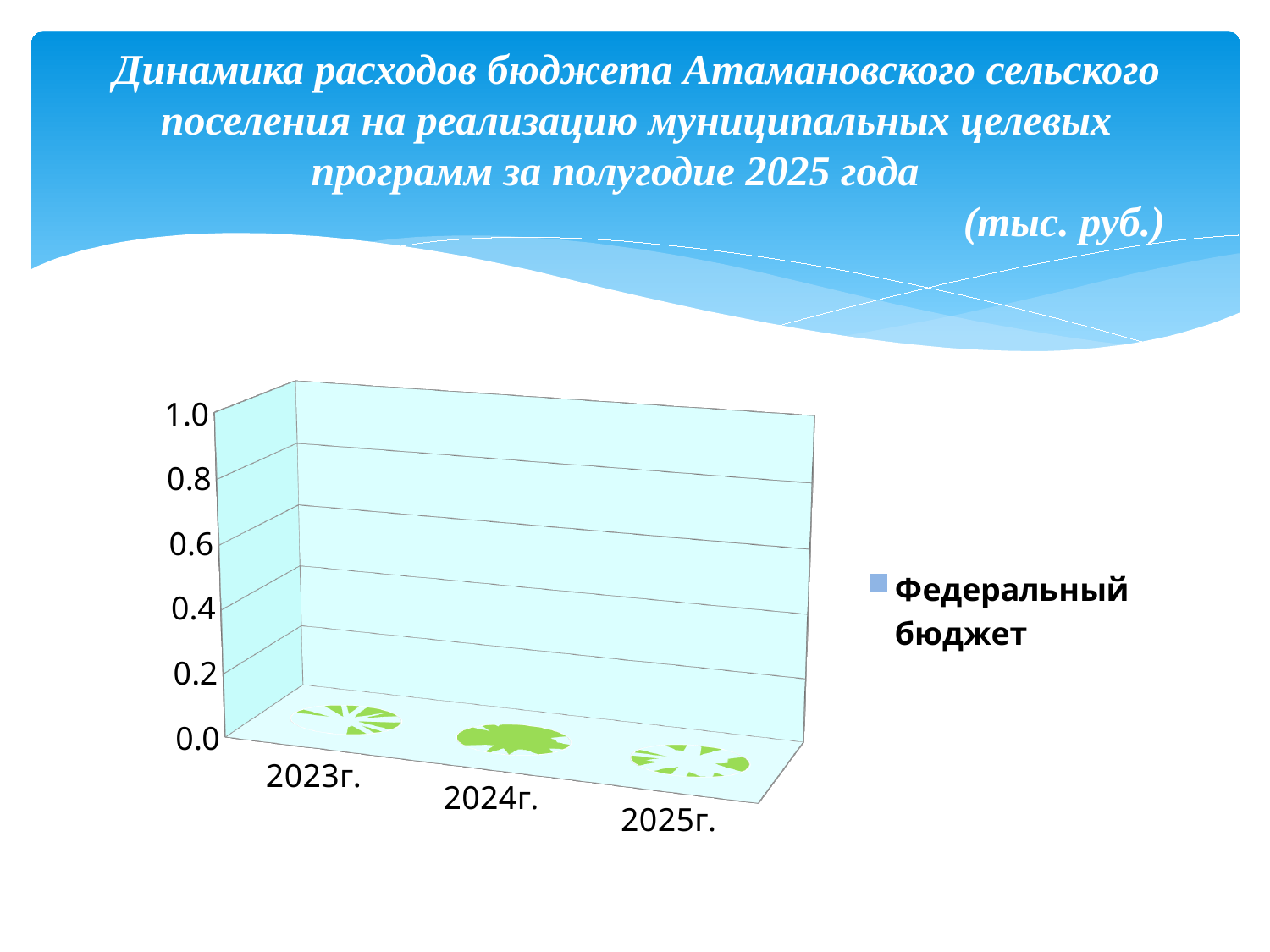
How many categories are shown on the x axis of the chart? 3 Is the value for 2025г. greater or less than 0.4? less What is the highest tick value shown on the vertical axis of the chart? 1.0 Is the value for 2023г. greater or less than 0.2? less How many series does the chart legend list? 1 Is the value for 2024г. greater or less than 0.2? less What kind of chart is shown on the slide? bar chart Which category labels appear on the x axis of the chart? 2023г., 2024г., 2025г. What is the name of the series listed in the chart legend? Федеральный бюджет